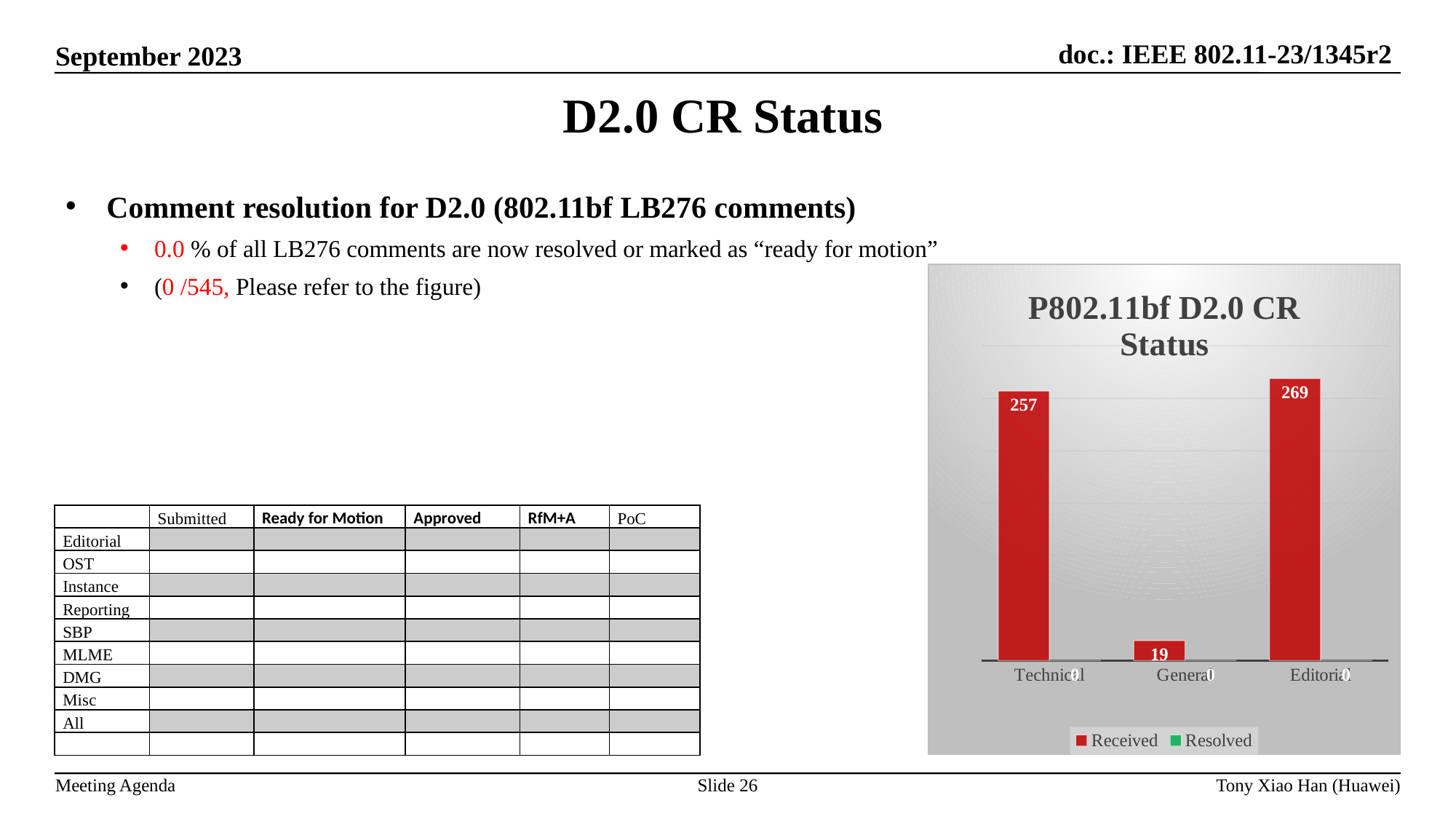
How many categories are shown on the x axis of the chart? 3 What is the Received value for Technical? 257 What is the Received value for Editorial? 269 What is the Received value for General? 19 Which category has the lowest Received value? General How many series does the chart legend list? 2 Which category has the highest Received value? Editorial What is the difference between the Received values for Editorial and Technical? 12 Which is larger, the Received value for Technical or for General? Technical What is the title of the chart? P802.11bf D2.0 CR Status What is the total of the Received values across all three categories? 545 What type of chart is shown on the slide? bar chart